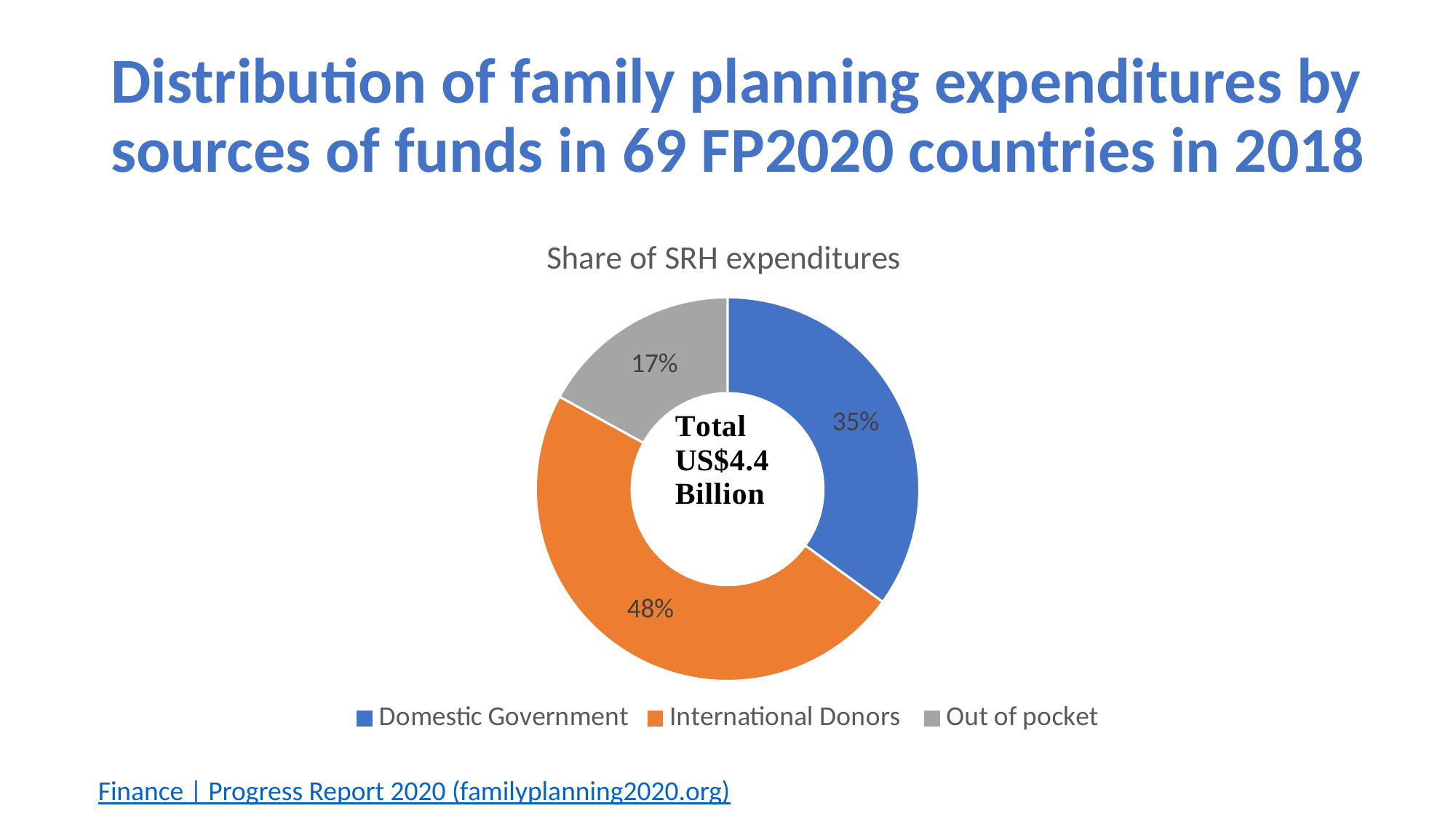
What is the combined share of Domestic Government and Out of pocket? 52% How many percentage points larger is the International Donors share than the Domestic Government share? 13 percentage points Which source of funds has the smallest share of SRH expenditures? Out of pocket What share of SRH expenditures comes from International Donors? 48% What is the total expenditure shown in the centre of the chart? US$4.4 Billion What is the title of the chart? Share of SRH expenditures What share of SRH expenditures is Out of pocket? 17% What kind of chart is shown on the slide? Doughnut (pie) chart How many sources of funds are shown in the chart? 3 What share of SRH expenditures comes from Domestic Government? 35% Which source of funds has the largest share of SRH expenditures? International Donors Which is larger, the Domestic Government share or the Out of pocket share? Domestic Government